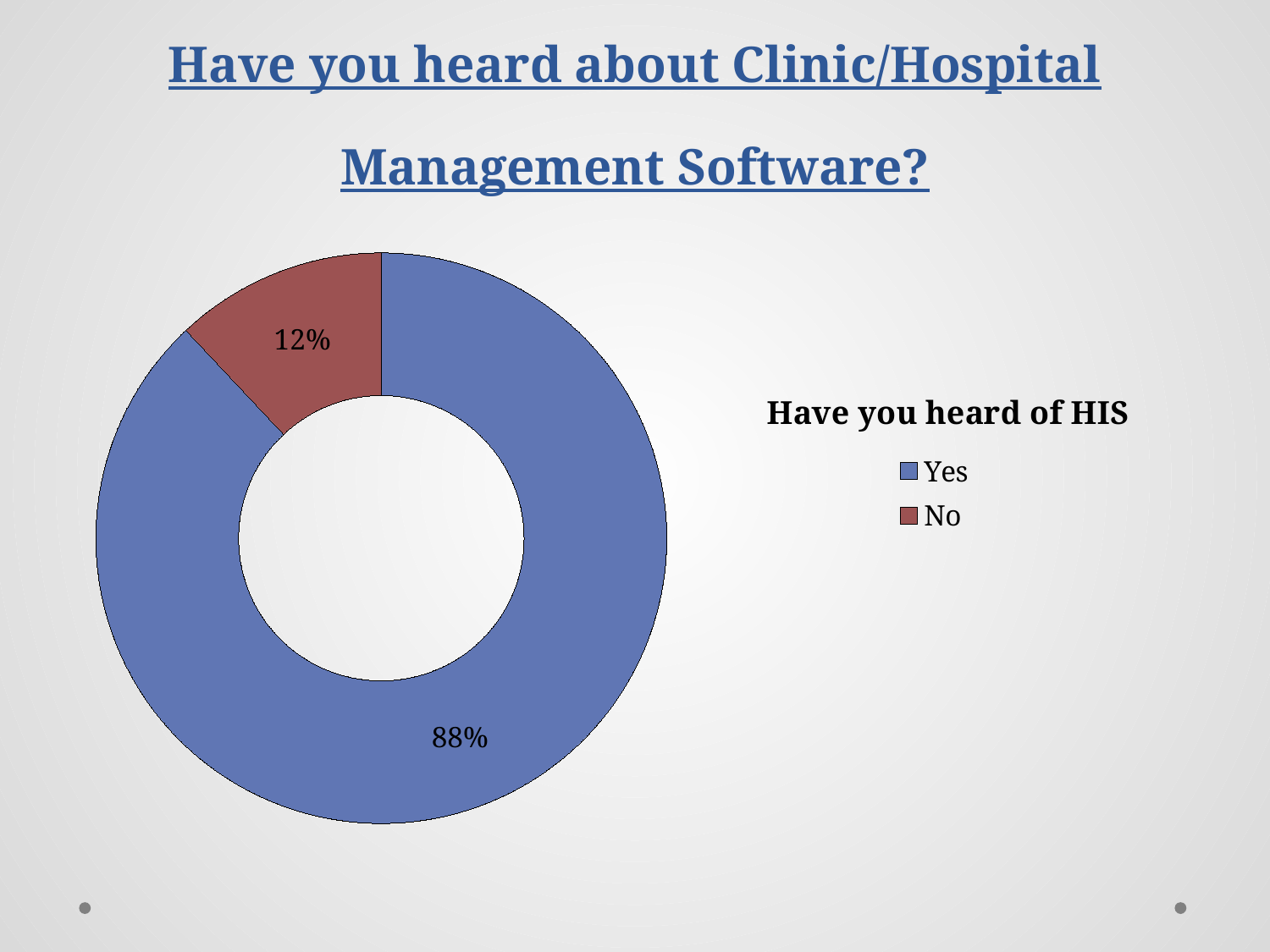
Which response has the largest share of the chart? Yes What is the title of the chart's legend? Have you heard of HIS What kind of chart is shown on the slide? Doughnut (pie) chart How many categories are shown in the chart? 2 What percentage of respondents answered Yes? 88% What is the difference in percentage points between the Yes and No shares? 76 Which response has the smallest share of the chart? No Which is larger, the share for Yes or the share for No? Yes What percentage of respondents answered No? 12% What colour represents the No response? Red How many entries does the legend list? 2